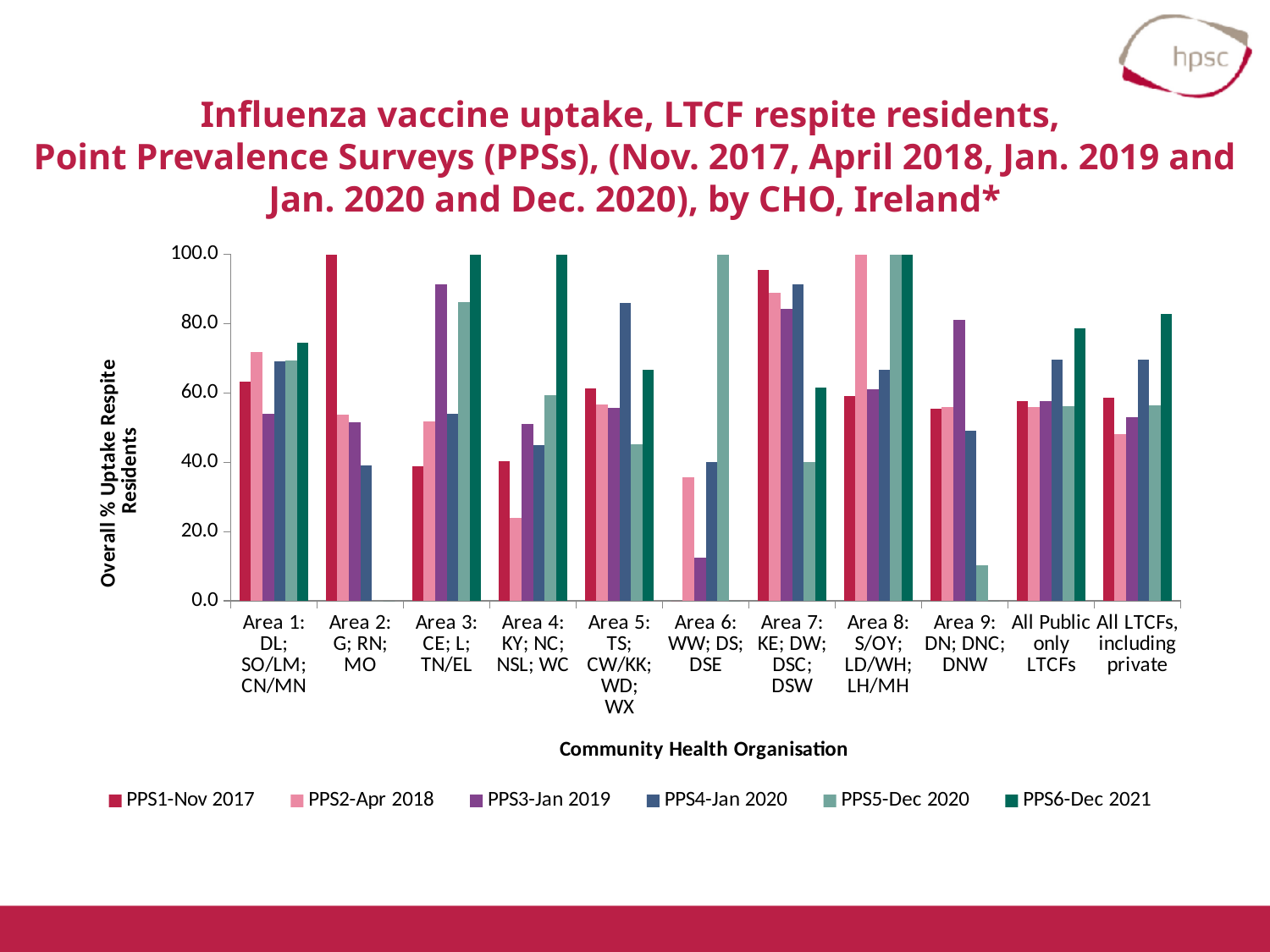
Is the value for PPS3-Jan 2019 in Area 6: WW; DS; DSE greater or less than 20.0? less How many series does the legend list? 6 In Area 6: WW; DS; DSE, which is larger, the value for PPS4-Jan 2020 or the value for PPS5-Dec 2020? PPS5-Dec 2020 What is the value for PPS6-Dec 2021 in Area 4: KY; NC; NSL; WC? 100.0 How many categories are shown along the x axis? 11 Which series has the highest value in Area 6: WW; DS; DSE? PPS5-Dec 2020 What is the value for PPS5-Dec 2020 in Area 6: WW; DS; DSE? 100.0 What kind of chart is shown on the slide? bar chart What is the value for PPS1-Nov 2017 in Area 2: G; RN; MO? 100.0 What is the title of the y axis? Overall % Uptake Respite Residents Is the value for PPS1-Nov 2017 in Area 7: KE; DW; DSC; DSW greater or less than 80.0? greater